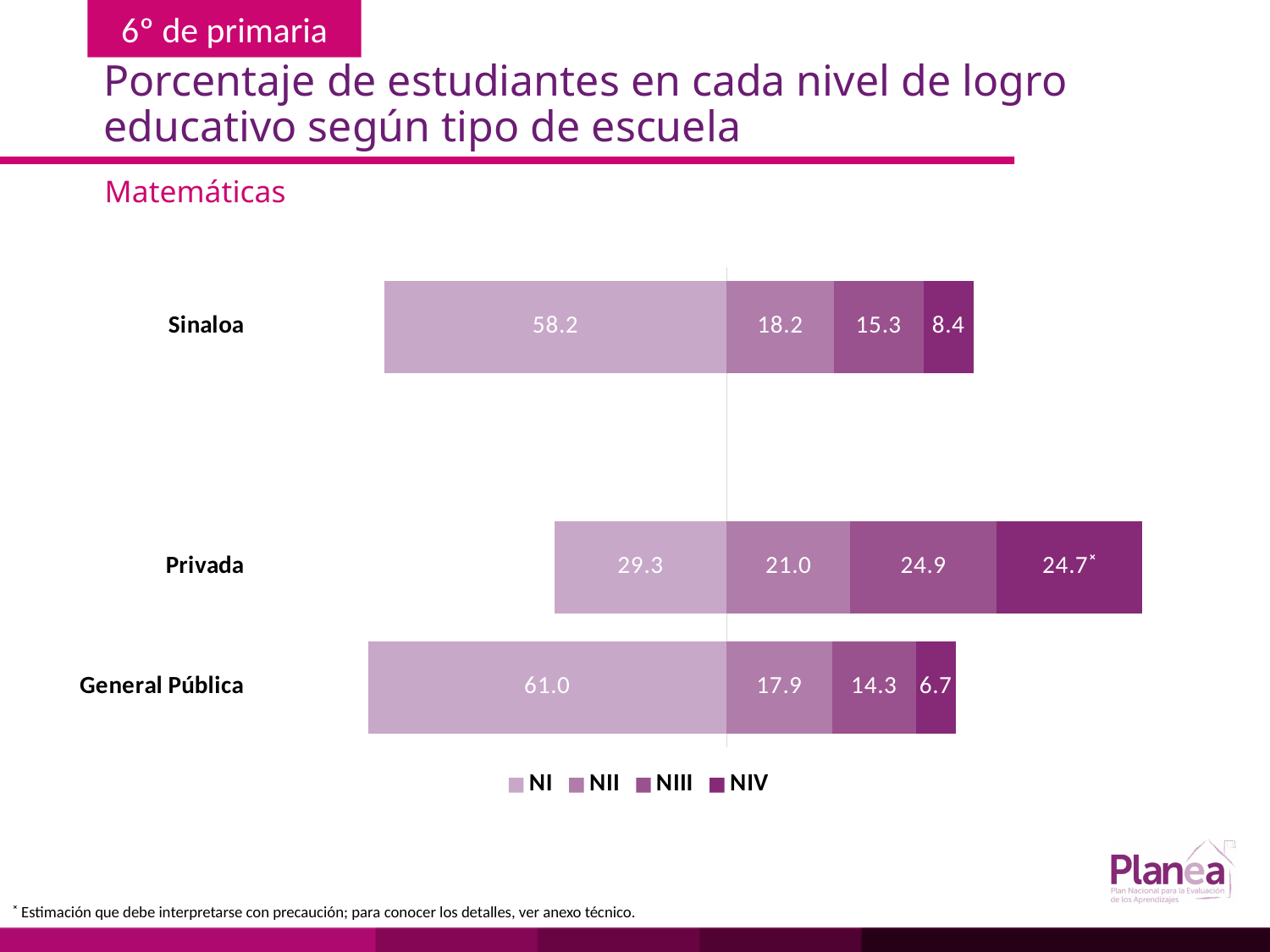
What is the NII value for Sinaloa? 18.2 What is the NIV value for Privada? 24.7 Which school type has the highest NI value? General Pública Which value in the chart is marked with an asterisk? 24.7 (NIV for Privada) Which school type has the lowest NIV value? General Pública What is the difference between the NI values for General Pública and Privada? 31.7 What is the NIII value for General Pública? 14.3 Which is larger, the NIII value for Privada or the NIII value for Sinaloa? Privada How many school types (categories) are shown in the chart? 3 What is the NI value for Sinaloa? 58.2 What type of chart is shown on the slide? Stacked bar chart How many series does the legend list? 4